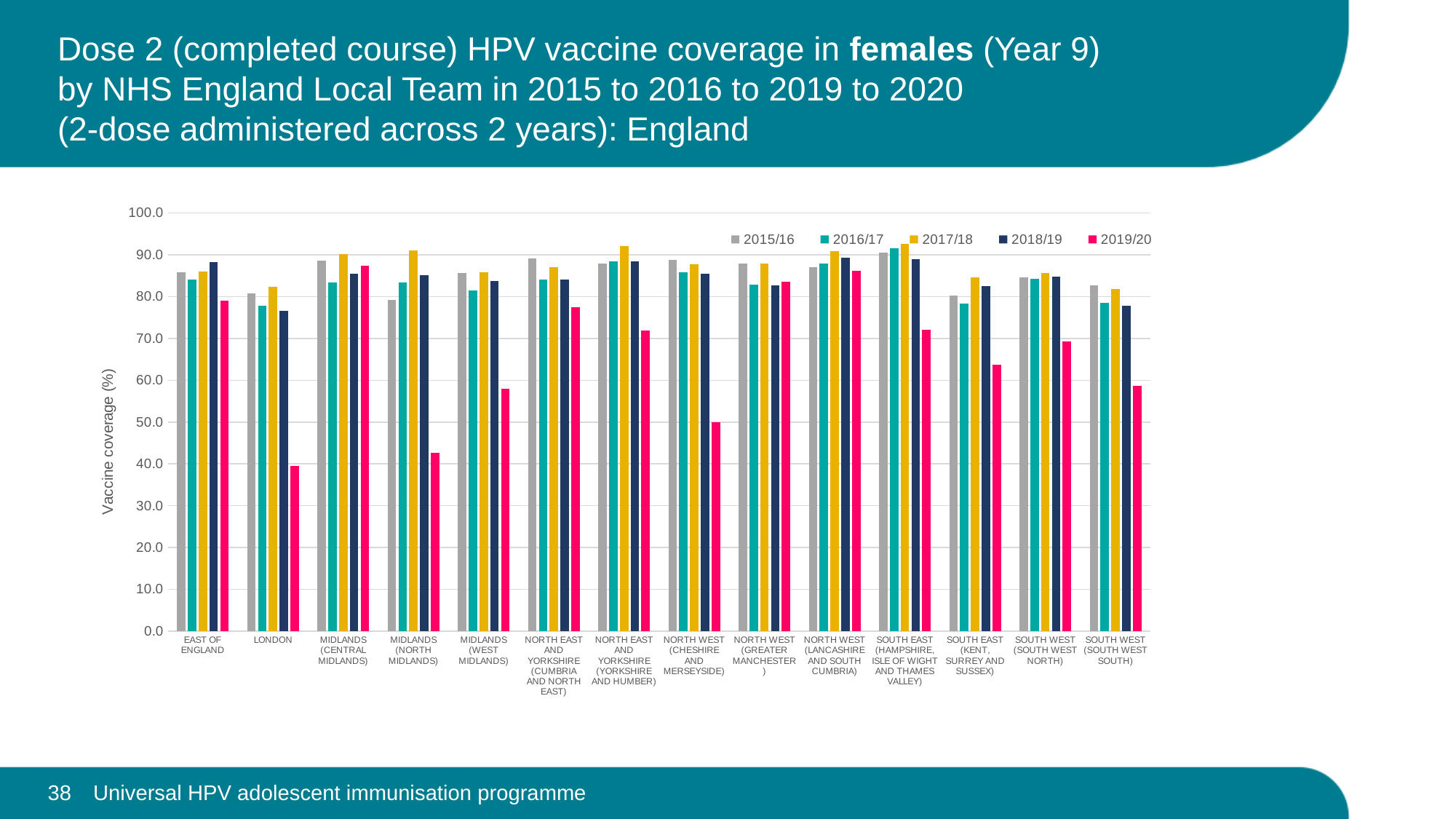
How many NHS England Local Teams are shown along the x axis? 14 Is the 2019/20 value for Midlands (North Midlands) greater or less than 50? less Which year is the last entry in the legend? 2019/20 Is the 2017/18 value for North East and Yorkshire (Yorkshire and Humber) greater or less than 90? greater Is the 2019/20 value for London greater or less than 50? less What kind of chart is shown on the slide? Bar chart What is the label on the y axis? Vaccine coverage (%) Which is larger, the 2019/20 value for East of England or the 2019/20 value for London? East of England For Midlands (North Midlands), which is larger, the 2017/18 value or the 2019/20 value? 2017/18 How many series does the legend list? 5